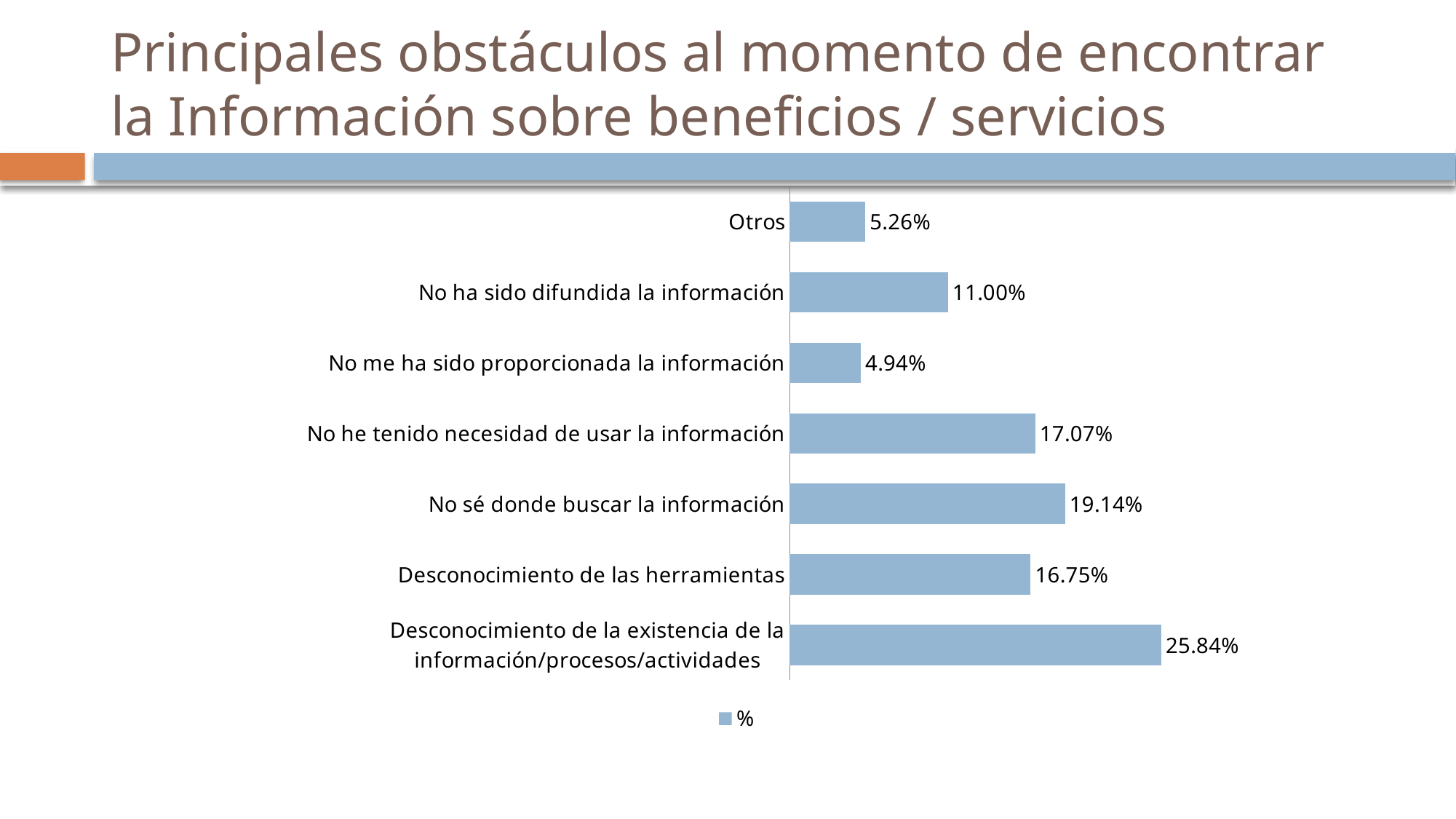
What is the value for "No ha sido difundida la información"? 11.00% What kind of chart is shown on the slide? Bar chart What is the value for "Otros"? 5.26% How many categories are shown in the chart? 7 What is the difference between the values for "Desconocimiento de la existencia de la información/procesos/actividades" and "Otros"? 20.58% Which category has the highest value? Desconocimiento de la existencia de la información/procesos/actividades What is the value for "No sé donde buscar la información"? 19.14% What is the difference between the values for "No sé donde buscar la información" and "No he tenido necesidad de usar la información"? 2.07% What is the legend entry shown below the chart? % What is the value for "Desconocimiento de las herramientas"? 16.75% Which category has the lowest value? No me ha sido proporcionada la información Which is larger: the value for "No ha sido difundida la información" or the value for "Desconocimiento de las herramientas"? Desconocimiento de las herramientas